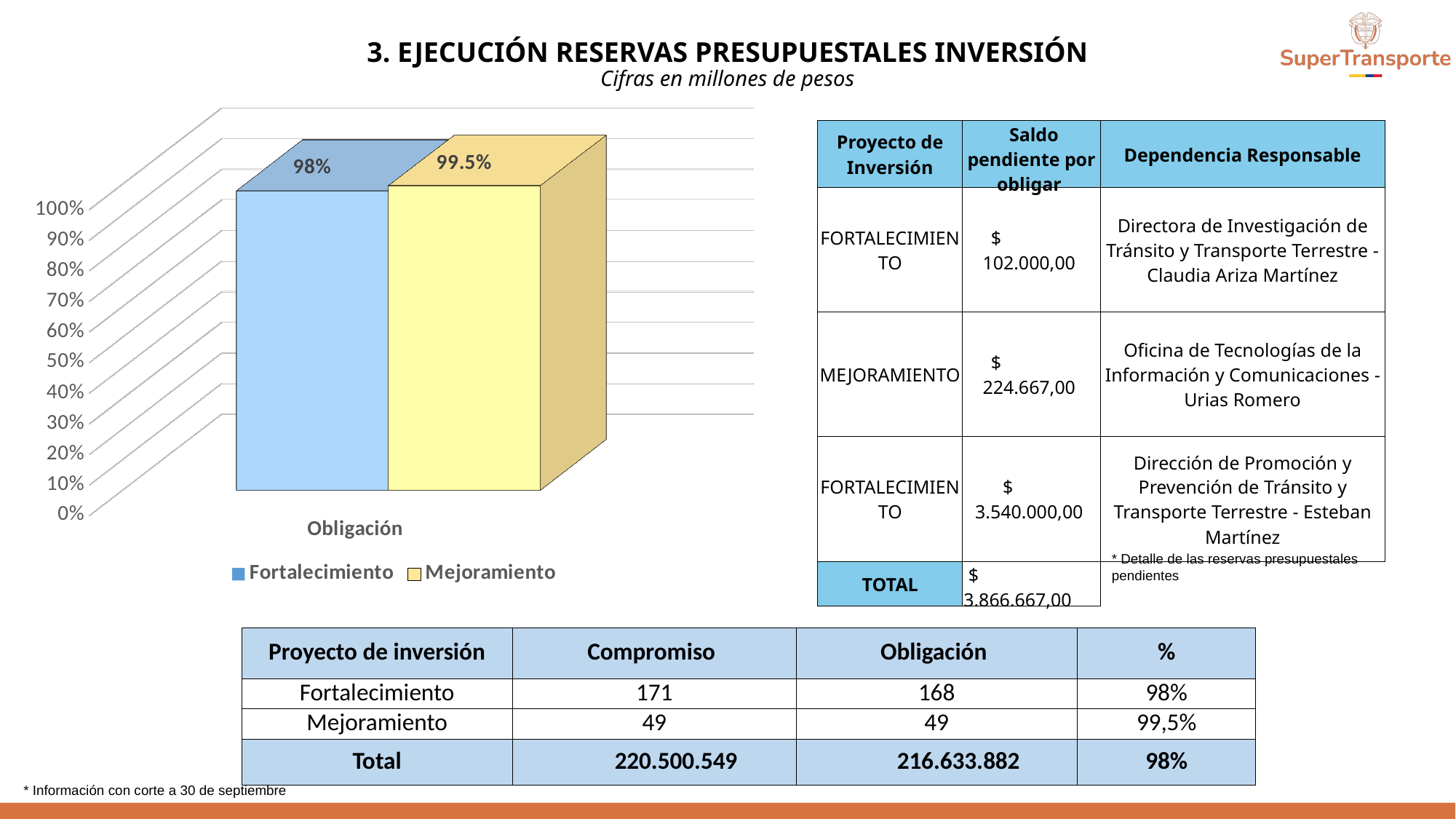
What kind of chart is shown on the slide? bar chart What is the value of the Mejoramiento bar in the chart? 99.5% What colour is the Mejoramiento bar in the chart? yellow How many series does the chart legend list? 2 What is the difference between the Mejoramiento and Fortalecimiento values in the chart? 1.5% What is the category label shown on the x axis of the chart? Obligación What is the highest tick value shown on the chart's vertical axis? 100% What is the value of the Fortalecimiento bar in the chart? 98% Which series has the lowest value in the chart? Fortalecimiento Is the value for Fortalecimiento greater or less than 90%? greater Which series has the higher value in the chart, Fortalecimiento or Mejoramiento? Mejoramiento